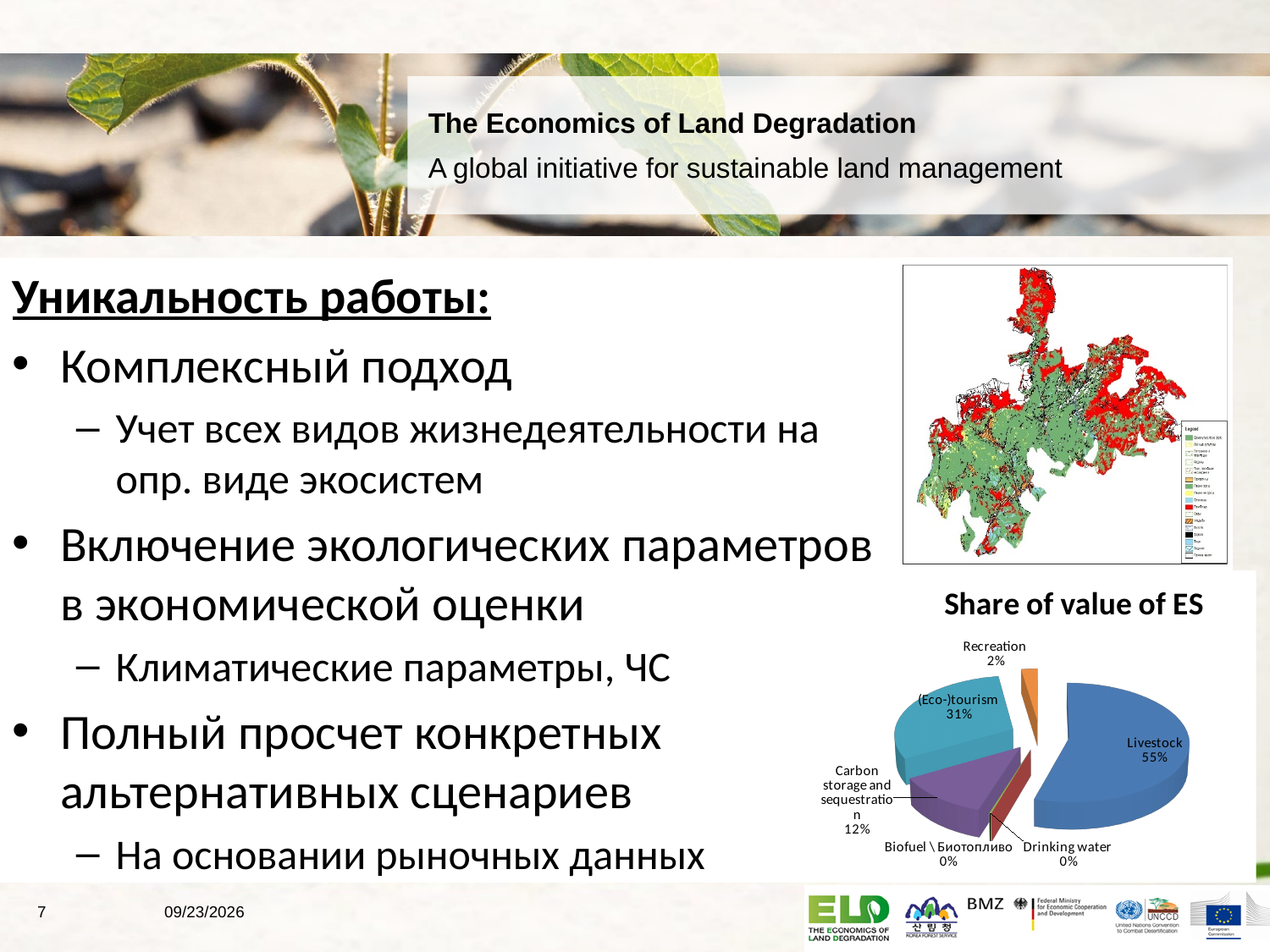
In the "Share of value of ES" chart, what share does Carbon storage and sequestration have? 12% In the "Share of value of ES" chart, what share does Drinking water have? 0% In the "Share of value of ES" chart, what is the difference in percentage points between Livestock and (Eco-)tourism? 24 percentage points In the "Share of value of ES" chart, what share does (Eco-)tourism have? 31% In the "Share of value of ES" chart, which is larger: (Eco-)tourism or Carbon storage and sequestration? (Eco-)tourism In the "Share of value of ES" chart, what share does Livestock have? 55% In the "Share of value of ES" chart, what share does Recreation have? 2% What is the title of the pie chart on the slide? Share of value of ES How many categories are labelled in the "Share of value of ES" pie chart? 6 What kind of chart is shown under the title "Share of value of ES"? pie chart In the "Share of value of ES" chart, what is the combined share of Livestock and (Eco-)tourism? 86% Which category has the largest share in the "Share of value of ES" chart? Livestock